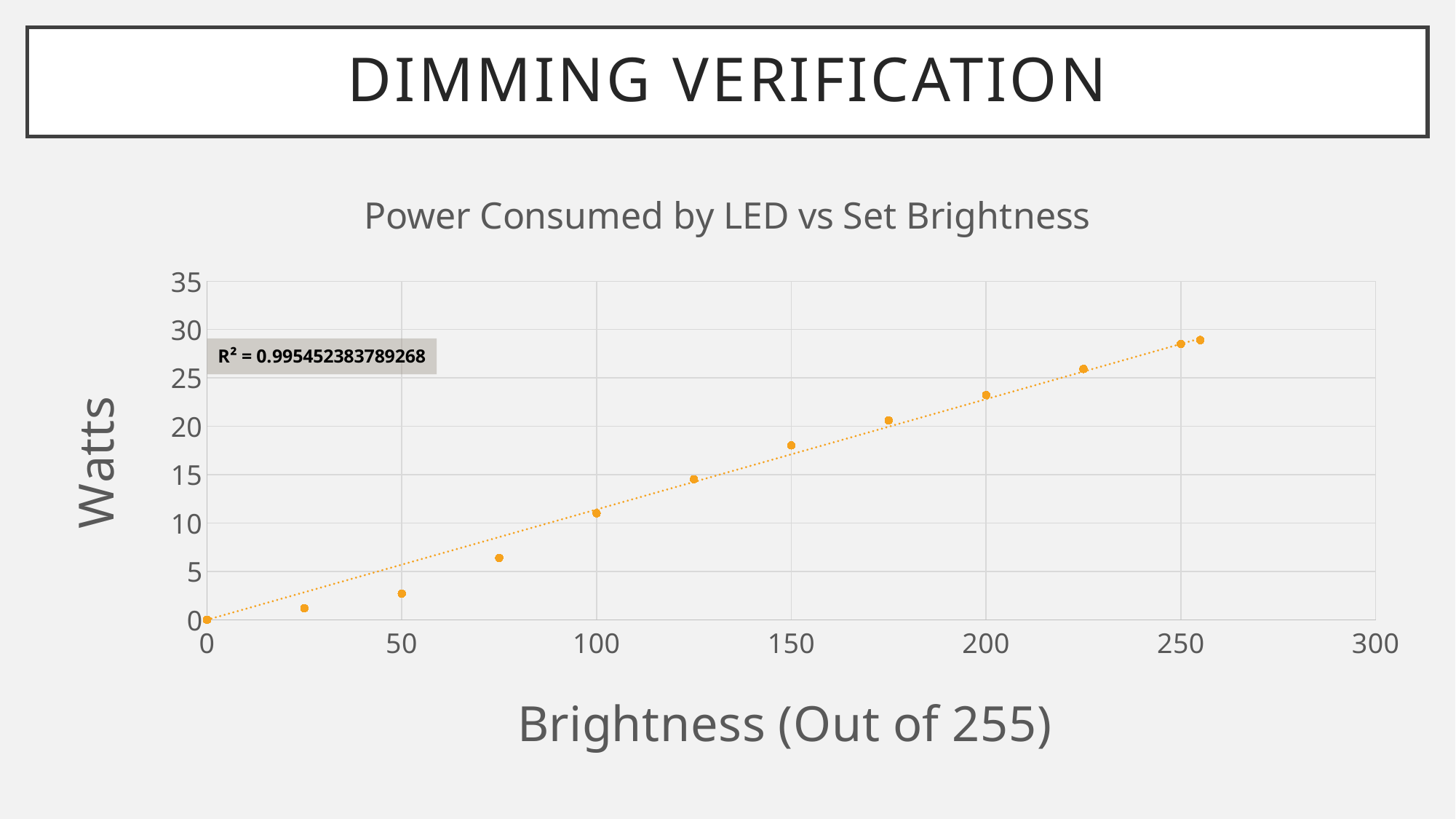
What kind of chart is shown on the slide? scatter chart Which brightness setting has the lowest power consumption? 0 Is the power value at brightness 200 greater or less than 20 watts? greater Is the power value at brightness 100 greater or less than 10 watts? greater Is the power value at brightness 150 greater or less than 15 watts? greater How many data points are plotted on the chart? 12 What is the title of the chart? Power Consumed by LED vs Set Brightness Do the power values rise or fall as brightness increases along the x axis? rise Which is larger, the power at brightness 200 or at brightness 100? brightness 200 What is the R² value shown on the chart? 0.995452383789268